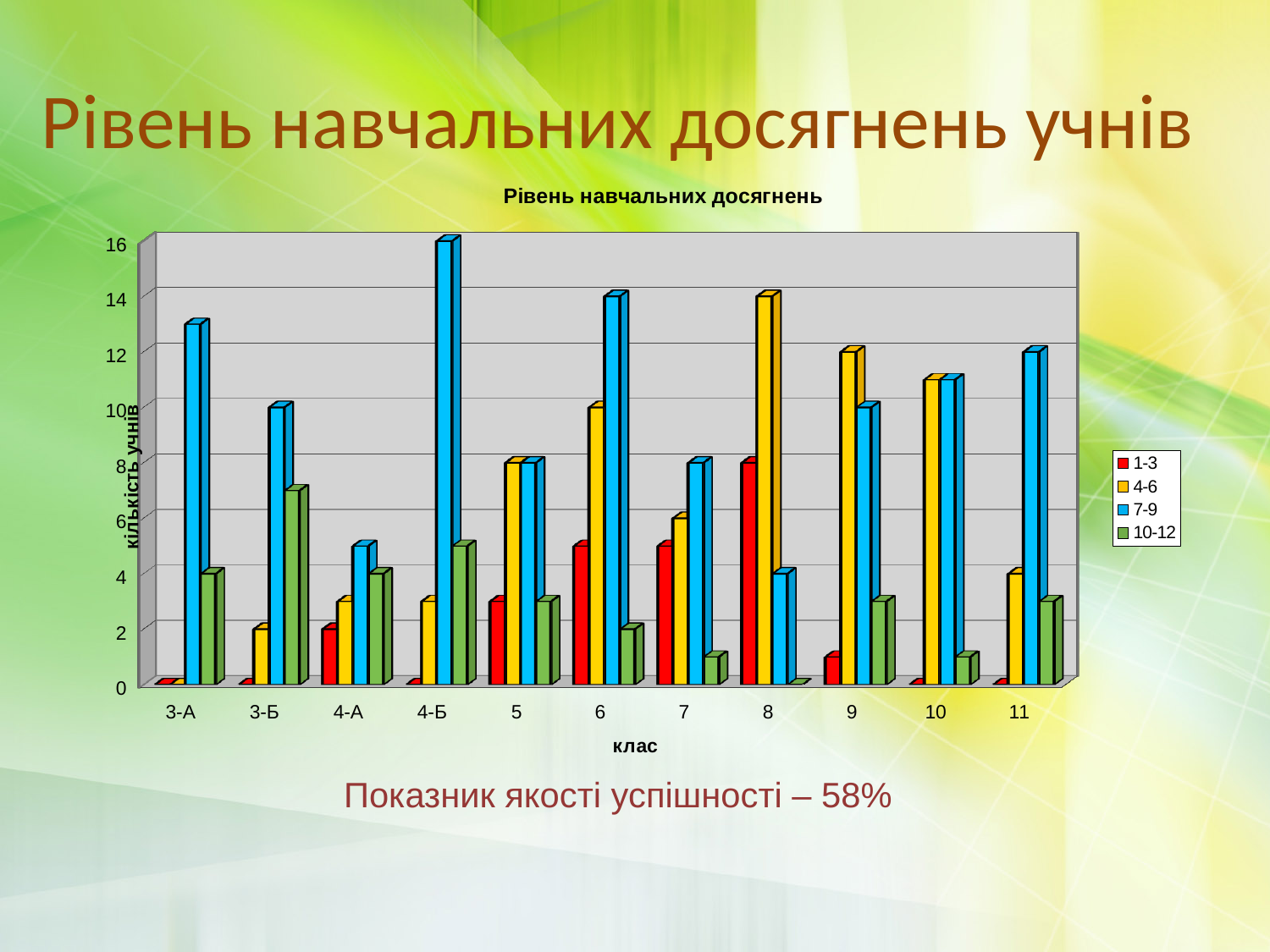
What is the title of the chart? Рівень навчальних досягнень For class 8, which series has the larger value: 4-6 or 7-9? 4-6 What is the value of the 7-9 series for class 6? 14 Which class has the highest value for the 7-9 series? 4-Б What is the value of the 4-6 series for class 8? 14 How many classes are shown along the x axis? 11 What kind of chart is shown on the slide? bar chart What is the value of the 7-9 series for class 4-Б? 16 Is the value of the 7-9 series for class 3-А greater or less than 12? greater What are the entries listed in the chart legend? 1-3, 4-6, 7-9, 10-12 How many series does the legend list? 4 Is the value of the 10-12 series for class 3-Б greater or less than 6? greater